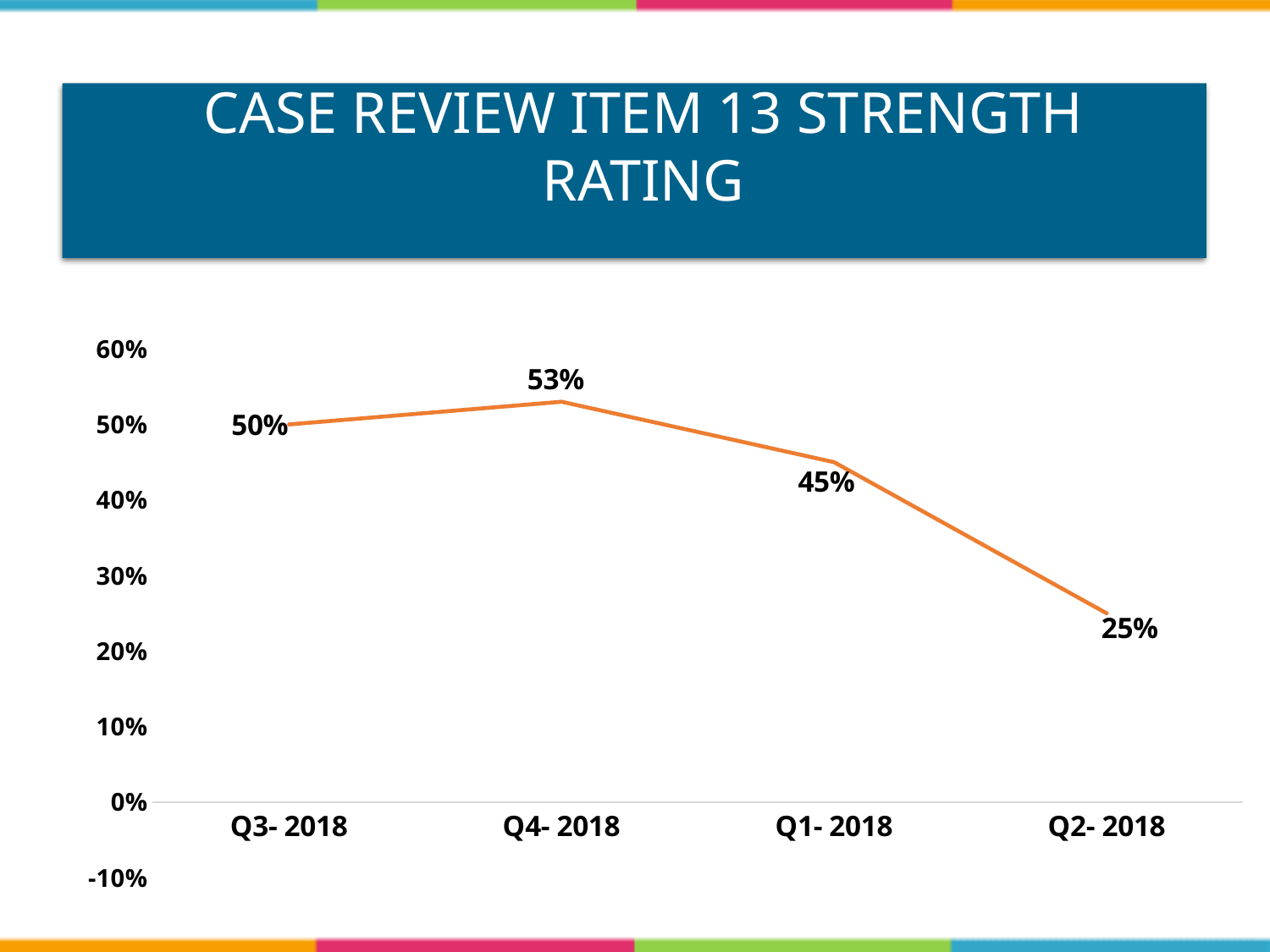
What is the value for Q4- 2018? 53% Is the value for Q2- 2018 greater or less than 30%? less What is the title of the chart? CASE REVIEW ITEM 13 STRENGTH RATING What is the difference between the values for Q4- 2018 and Q2- 2018? 28% Which quarter has the highest value? Q4- 2018 What is the value for Q1- 2018? 45% What is the value for Q3- 2018? 50% Which is larger, the value for Q3- 2018 or the value for Q1- 2018? Q3- 2018 What kind of chart is shown on the slide? line chart How many quarters are plotted on the chart? 4 Which quarter has the lowest value? Q2- 2018 What is the value for Q2- 2018? 25%